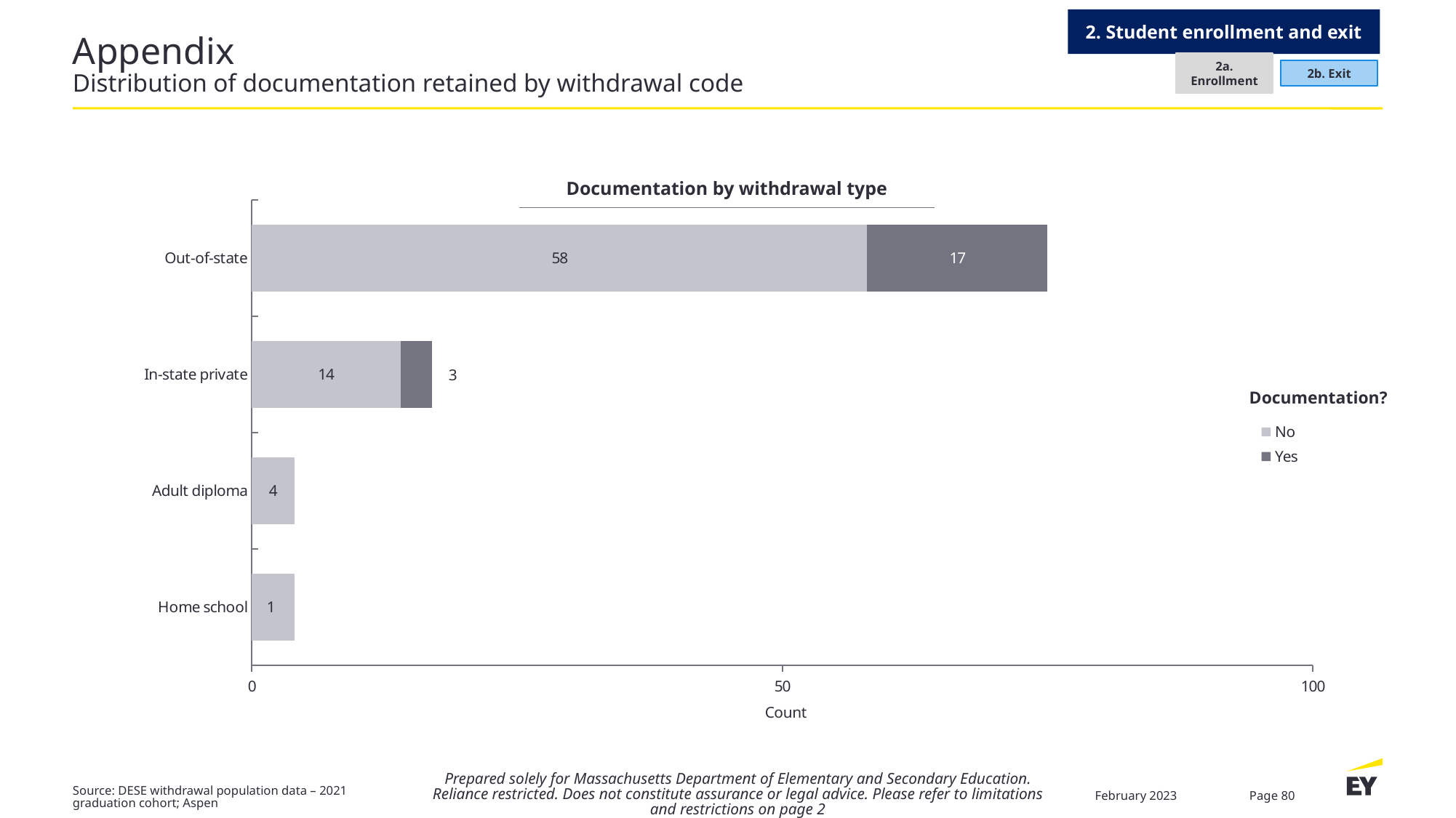
Which withdrawal type has the lowest 'No' documentation count? Home school What is the 'No' documentation count for Out-of-state? 58 Which withdrawal type has the highest 'No' documentation count? Out-of-state Is the 'No' count for Out-of-state greater or less than 50? greater What is the 'No' documentation count for Home school? 1 What is the total count for the Out-of-state bar? 75 What type of chart is shown? Stacked bar chart What is the total count for the In-state private bar? 17 What is the 'Yes' documentation count for In-state private? 3 How many withdrawal types are shown on the chart? 4 What is the 'No' documentation count for Adult diploma? 4 What is the difference between the 'No' and 'Yes' counts for Out-of-state? 41